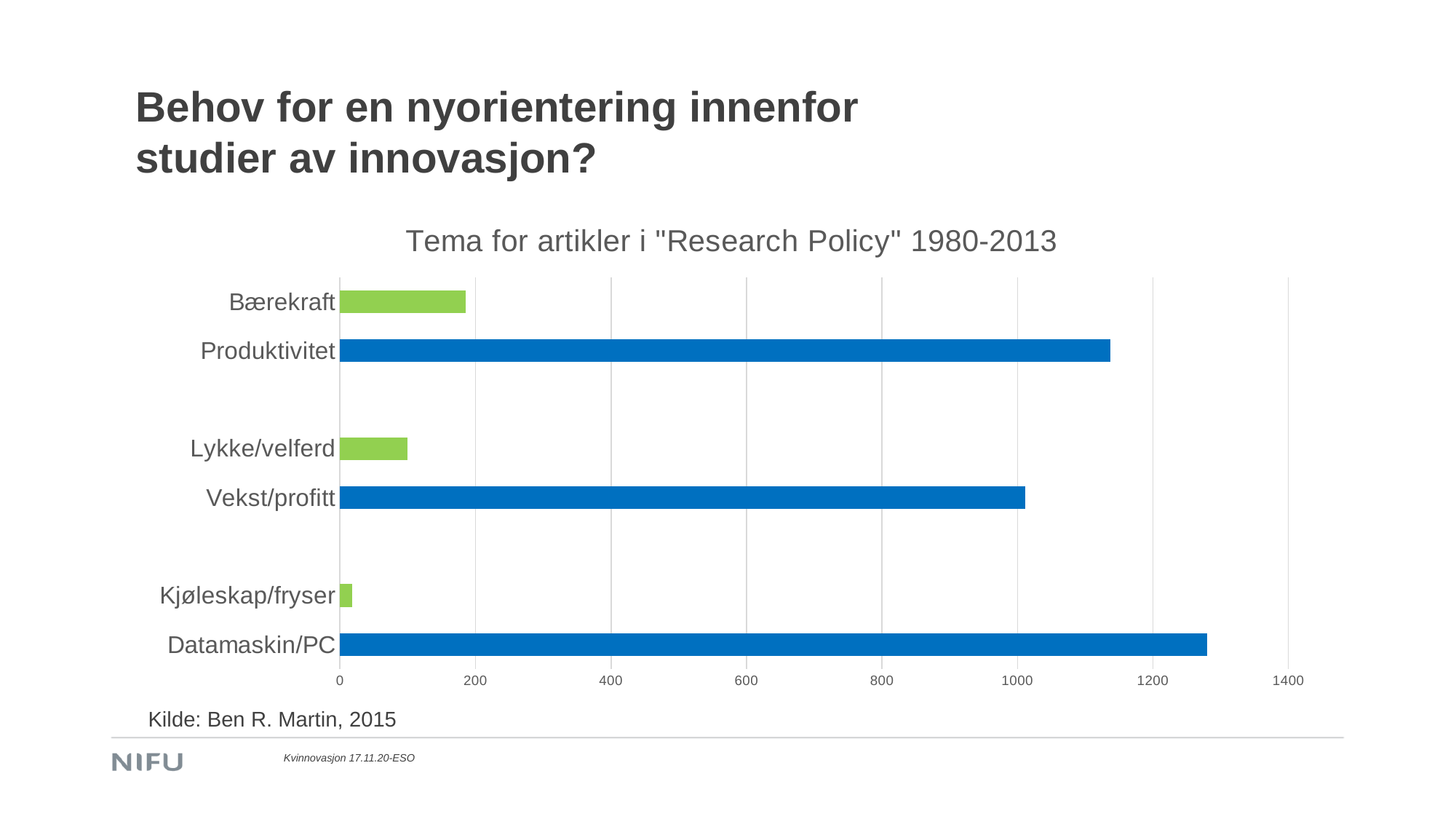
Which is larger, the value for Bærekraft or the value for Lykke/velferd? Bærekraft What kind of chart is shown on the slide? bar chart What is the title of the chart? Tema for artikler i "Research Policy" 1980-2013 Which category has the lowest value? Kjøleskap/fryser What colour are the bars for Bærekraft, Lykke/velferd and Kjøleskap/fryser? green How many categories are plotted in the chart? 6 Is the value for Kjøleskap/fryser greater or less than 200? less Which category has the highest value? Datamaskin/PC Which is larger, the value for Produktivitet or the value for Vekst/profitt? Produktivitet Is the value for Bærekraft greater or less than 200? less Is the value for Datamaskin/PC greater or less than 1200? greater